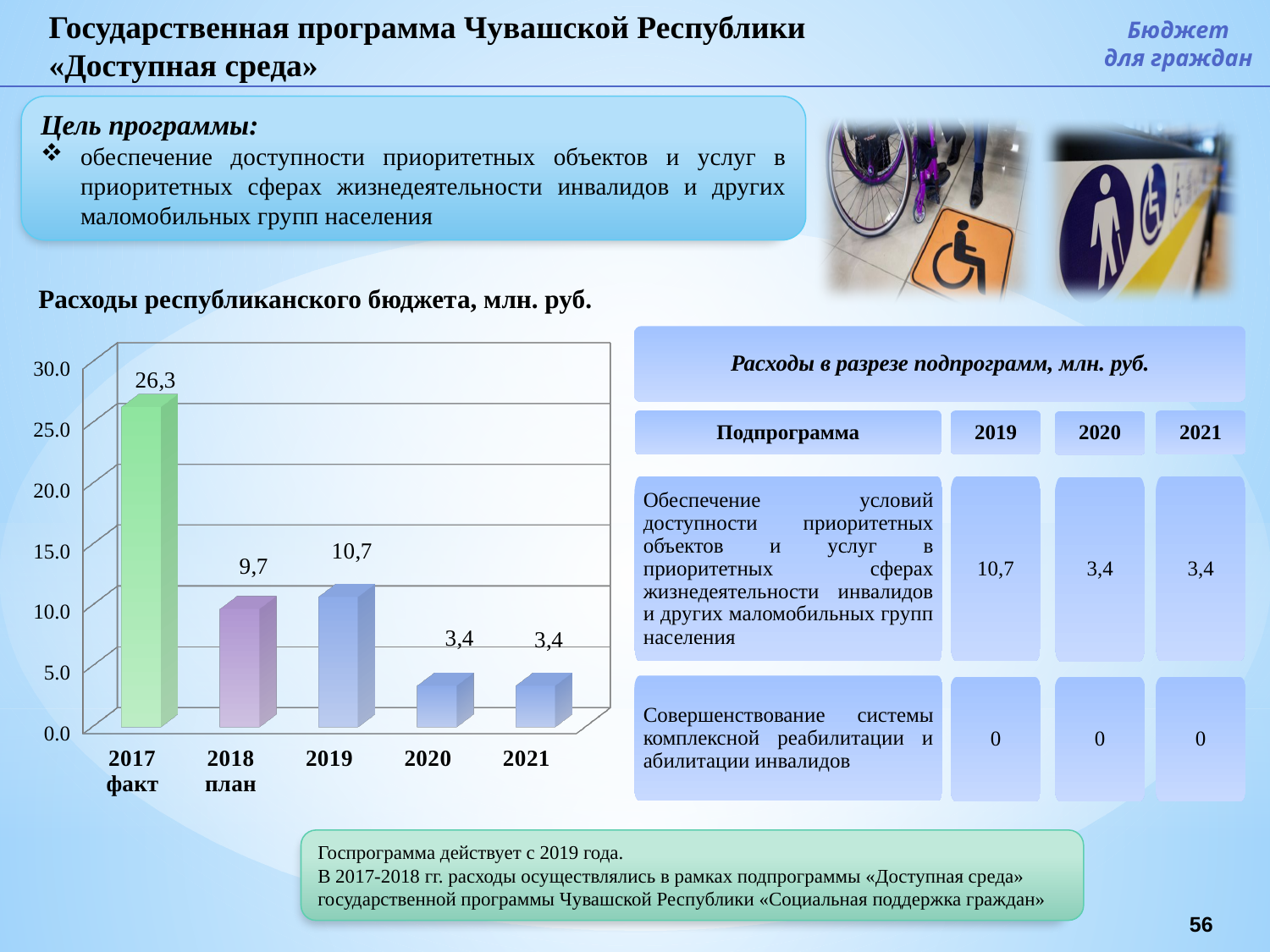
What is the value for 2021 in the chart? 3,4 What is the value for 2018 (план) in the chart? 9,7 How many years (categories) are shown in the chart? 5 What is the title of the chart on the slide? Расходы республиканского бюджета, млн. руб. Is the value for 2017 greater or less than 25.0? greater Which is larger in the chart, the value for 2018 or the value for 2019? 2019 What is the value for 2019 in the chart? 10,7 What is the difference between the values for 2017 and 2019 in the chart? 15,6 What is the difference between the values for 2019 and 2018 in the chart? 1,0 What is the value for 2017 (факт) in the chart 'Расходы республиканского бюджета, млн. руб.'? 26,3 What kind of chart is shown on the slide? bar chart Which year has the highest value in the chart? 2017 факт